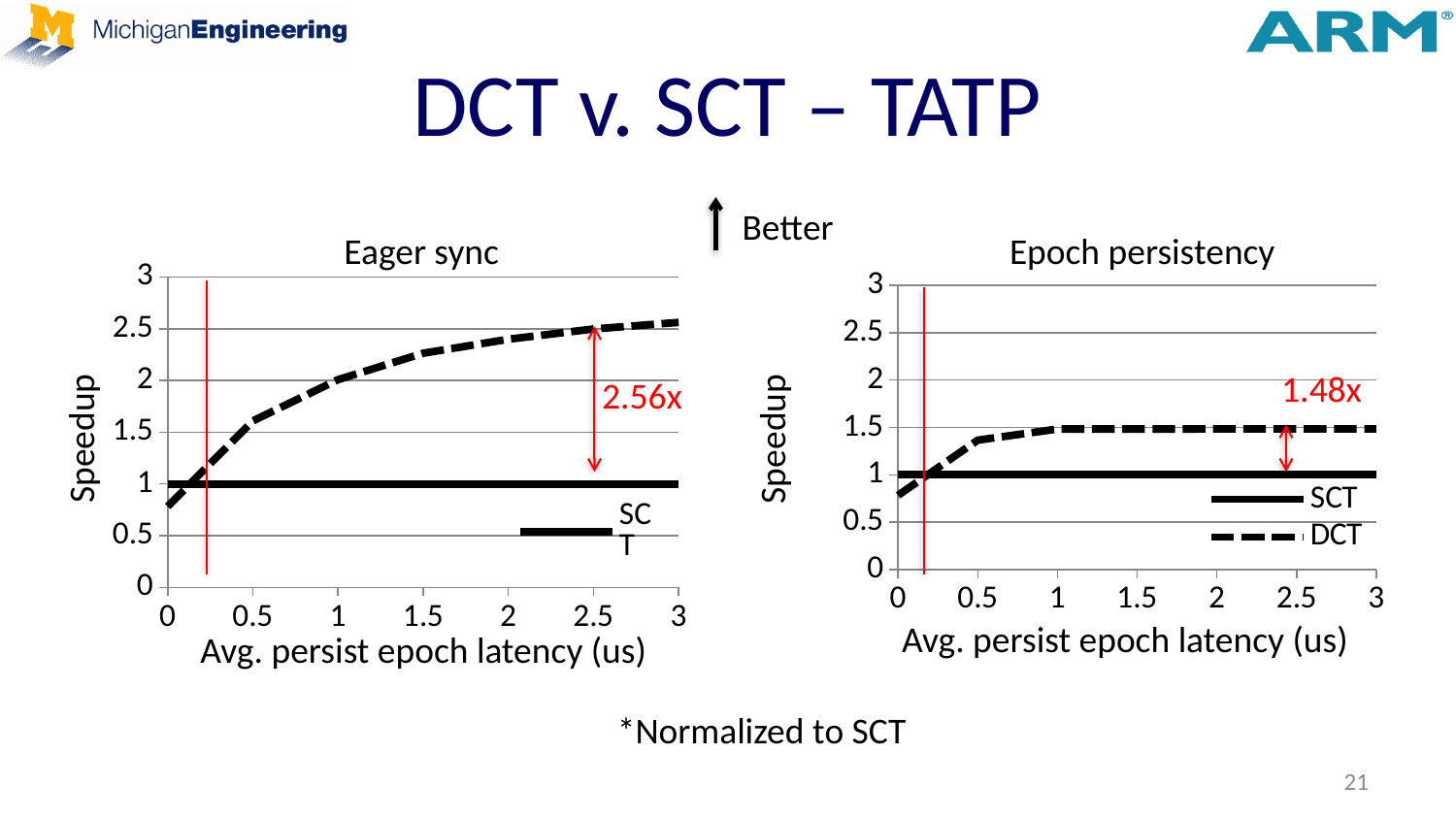
In the Epoch persistency chart, which series has the higher speedup at a latency of 2 us, SCT or DCT? DCT In the Eager sync chart, what speedup factor is annotated in red? 2.56x What is the x-axis label of the Eager sync chart? Avg. persist epoch latency (us) What is the y-axis label of the Epoch persistency chart? Speedup In the Eager sync chart, does the DCT speedup rise or fall as the average persist epoch latency increases? rise Which chart shows the larger annotated speedup factor, Eager sync or Epoch persistency? Eager sync What kind of chart is the Eager sync chart? line chart In the Eager sync chart, is the DCT speedup at a latency of 2.5 us greater or less than 2? greater In the Eager sync chart, what is the speedup of the SCT line? 1 In the Epoch persistency chart, is the DCT speedup at a latency of 3 us greater or less than 2? less In the Epoch persistency chart, what speedup factor is annotated in red? 1.48x How many series does the legend of the Epoch persistency chart list? 2